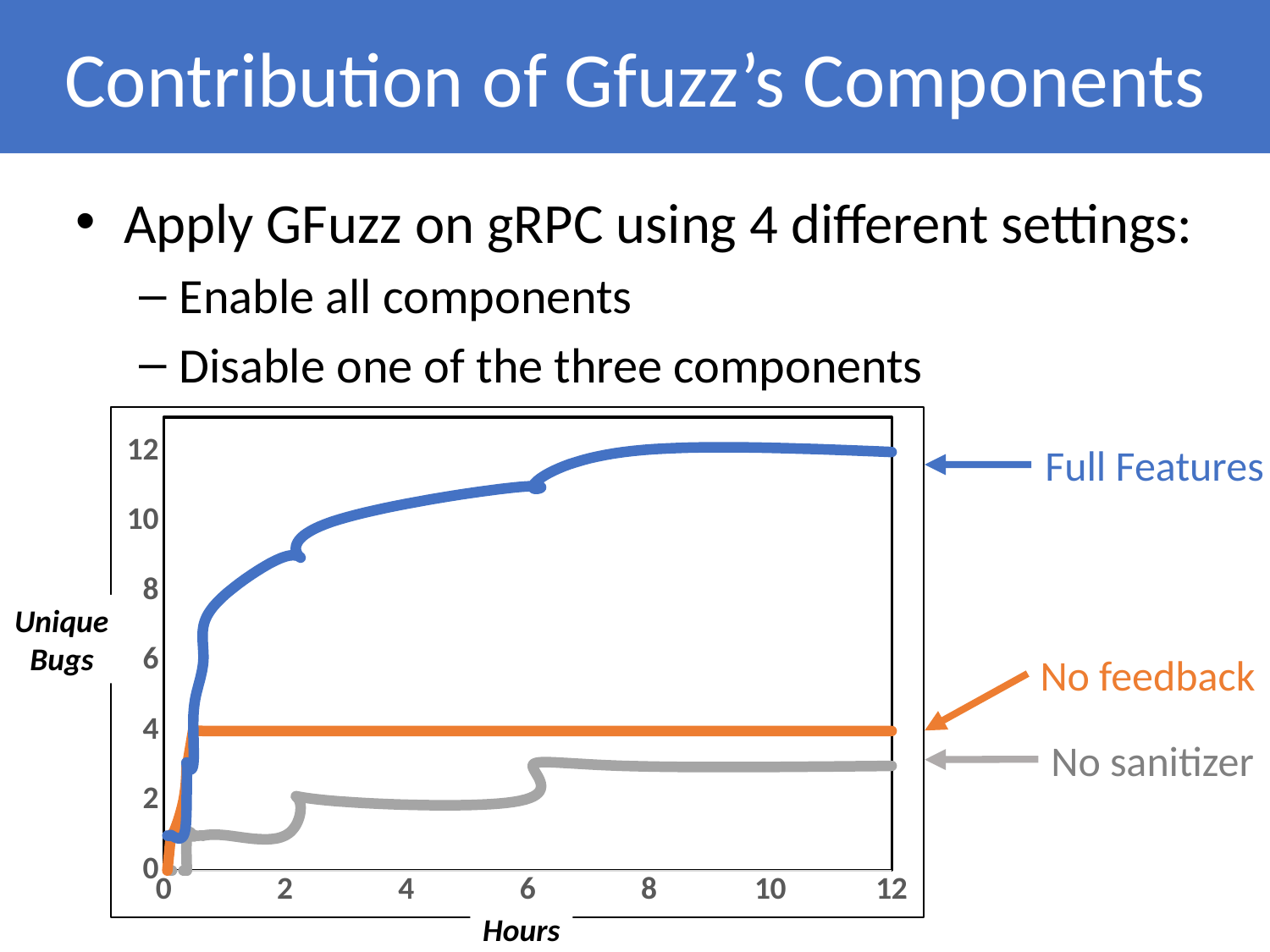
How many unique bugs does the No feedback series reach at 12 hours? 4 Which series has the lowest number of unique bugs at 12 hours? No sanitizer Is the value for Full Features at 12 hours greater or less than 10? greater Is the value for No sanitizer at 1 hour greater or less than 2? less What colour is the Full Features line? blue What is the label of the x axis? Hours Does the Full Features series rise or fall as hours increase? rise At 6 hours, which series has more unique bugs: Full Features or No feedback? Full Features What kind of chart is shown on the slide? line chart Which series has the highest number of unique bugs at 12 hours? Full Features Is the value for No sanitizer at 12 hours greater or less than 4? less How many series are plotted in the chart? 3